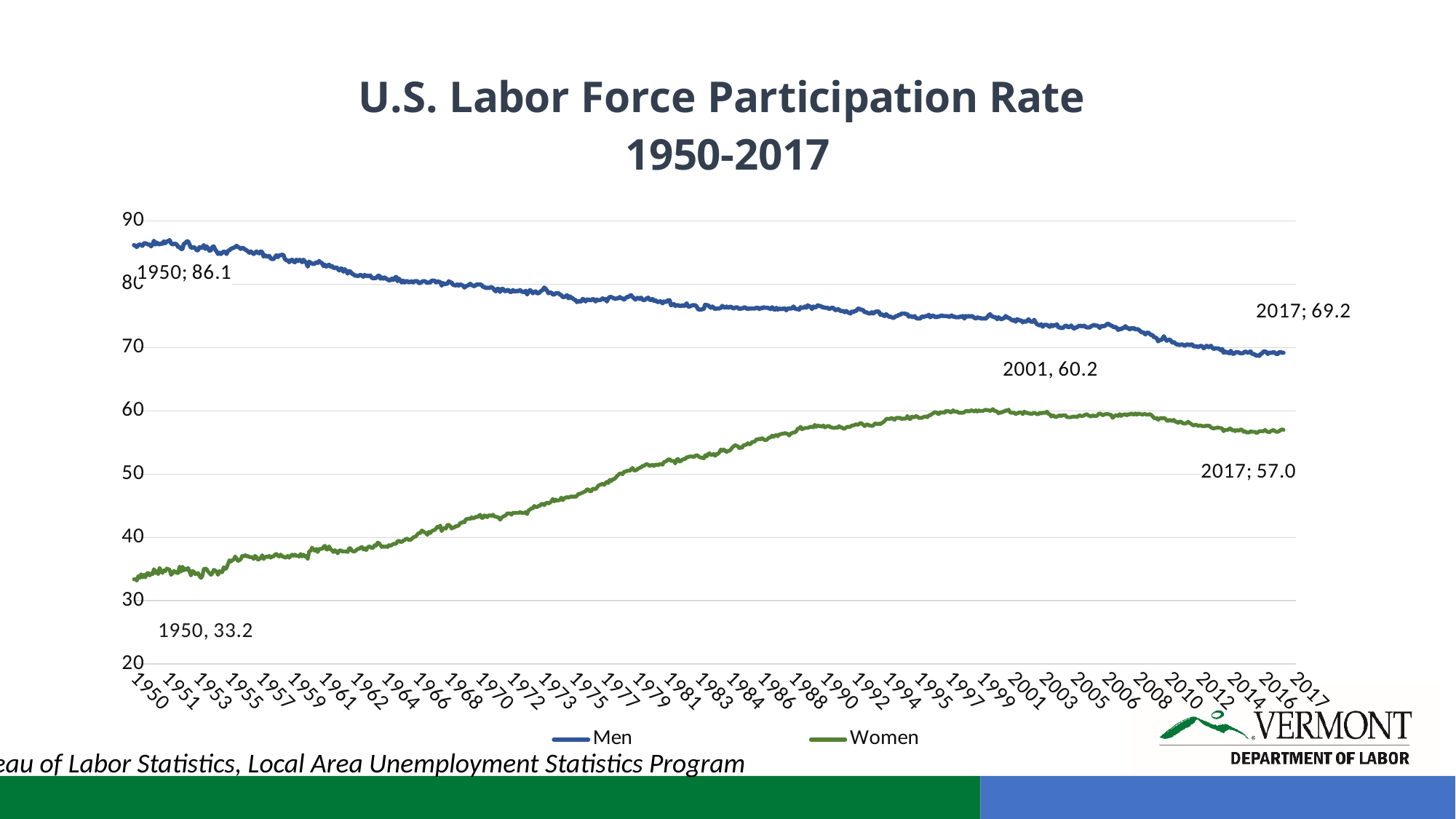
What was the labor force participation rate for women in 2017? 57.0 What is the difference between the men's and women's participation rates in 2017? 12.2 What kind of chart is shown on the slide? Line chart By how much did the men's labor force participation rate fall from 1950 to 2017? 16.9 What was the labor force participation rate for women in 2001? 60.2 Which series has the higher participation rate in 2017, Men or Women? Men Is the women's participation rate in 1990 greater or less than 50? greater What was the labor force participation rate for men in 1950? 86.1 What was the labor force participation rate for women in 1950? 33.2 What was the labor force participation rate for men in 2017? 69.2 How many series does the legend list? 2 Does the Men line rise or fall from 1950 to 2017? Fall